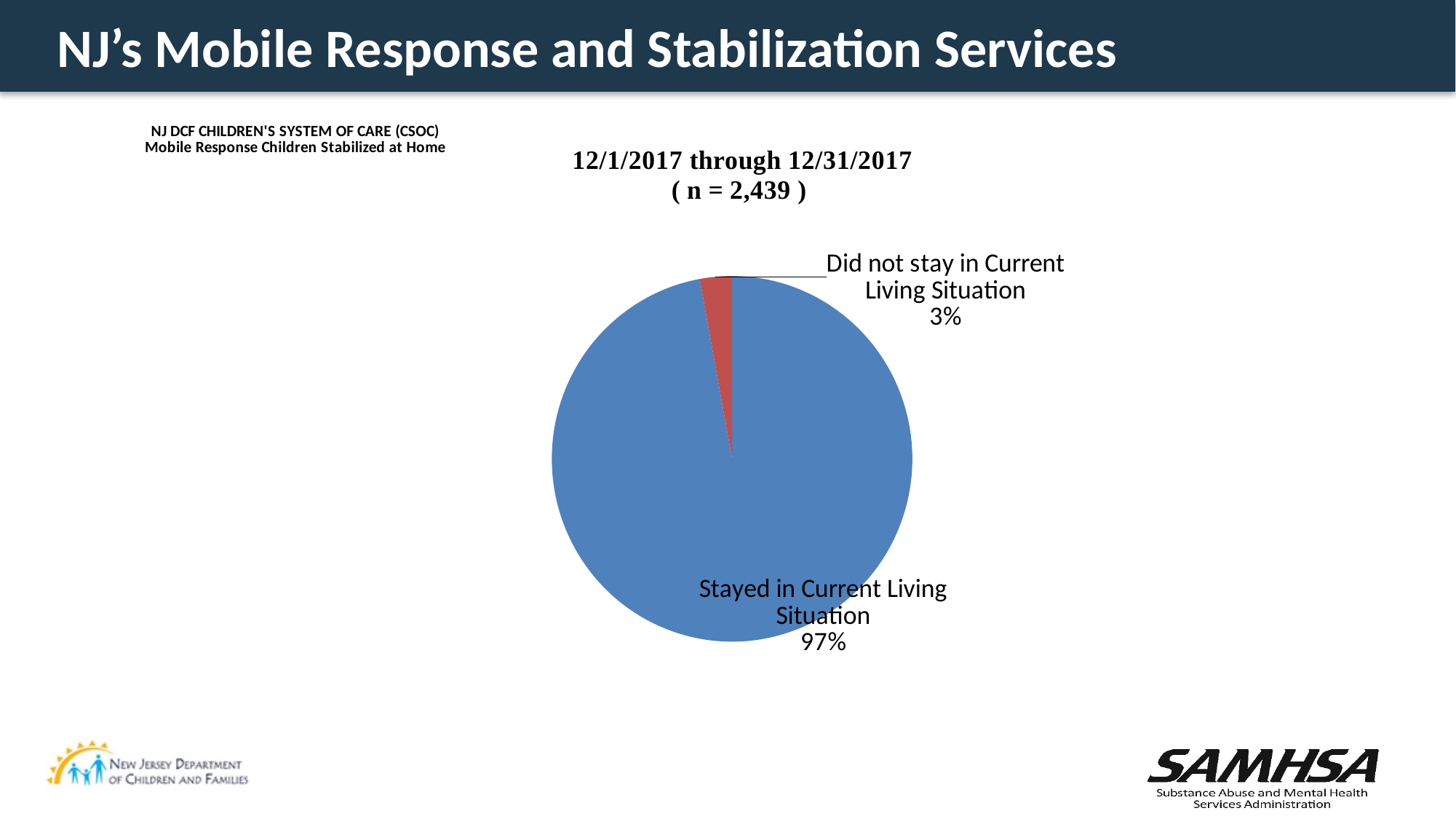
Which category has the largest share of the pie? Stayed in Current Living Situation What is the difference in percentage points between the 'Stayed in Current Living Situation' slice and the 'Did not stay in Current Living Situation' slice? 94 percentage points Which category has the smallest share of the pie? Did not stay in Current Living Situation What is the sample size (n) shown above the pie chart? 2,439 Which is larger: the share that stayed in their current living situation or the share that did not? Stayed in Current Living Situation What percentage of children stayed in their current living situation? 97% What date range does the pie chart cover? 12/1/2017 through 12/31/2017 What percentage of children did not stay in their current living situation? 3% How many slices does the pie chart have? 2 What kind of chart is shown on the slide? pie chart